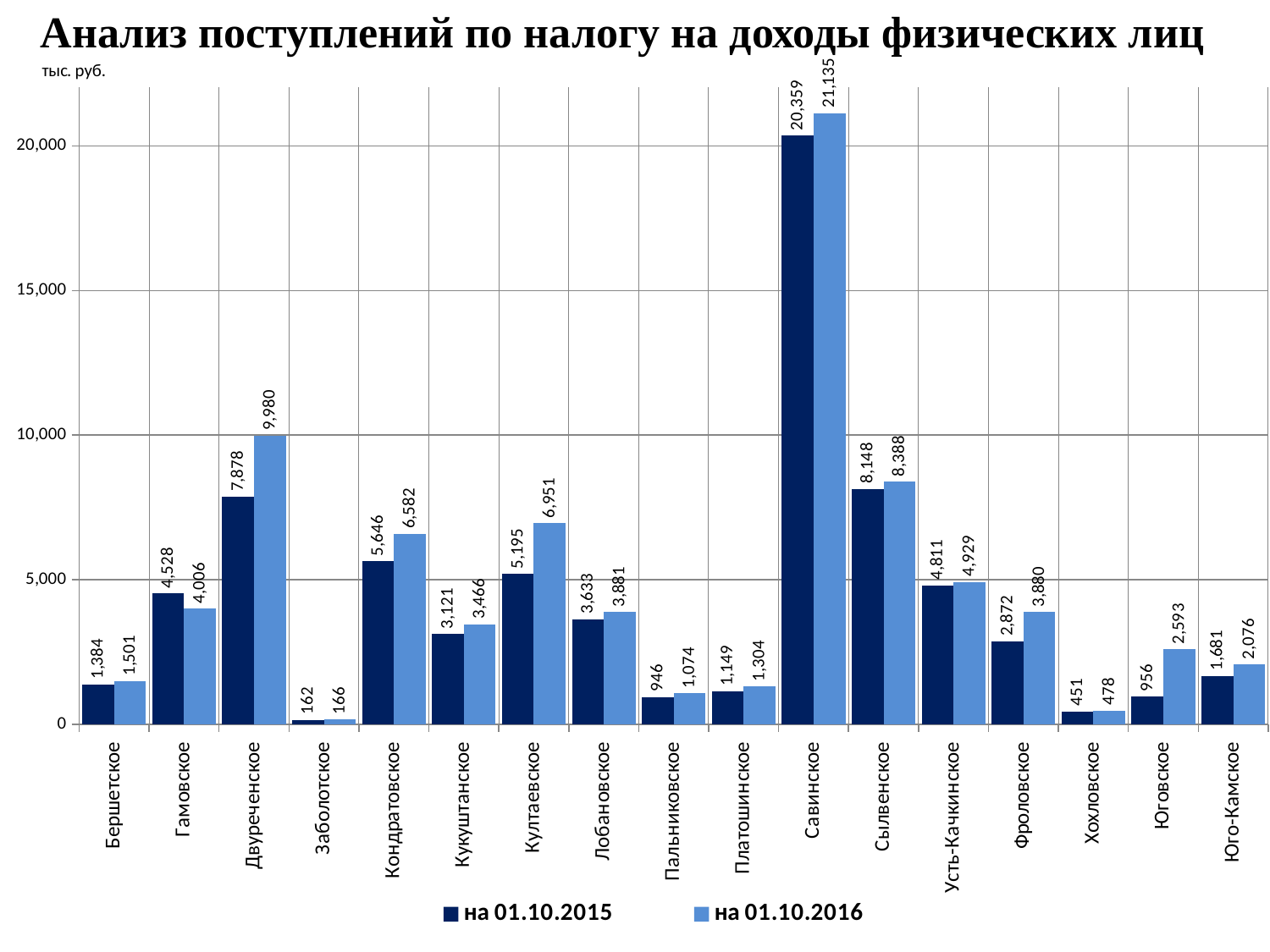
What kind of chart is shown on the slide? bar chart What is the difference between the на 01.10.2016 and на 01.10.2015 values for Савинское? 776 For Гамовское, which series has the larger value: на 01.10.2015 or на 01.10.2016? на 01.10.2015 What is the difference between the на 01.10.2016 and на 01.10.2015 values for Двуреченское? 2,102 Which category has the highest value in the series на 01.10.2015? Савинское What is the value for Савинское in the series на 01.10.2016? 21,135 What is the value for Двуреченское in the series на 01.10.2015? 7,878 How many series does the legend list? 2 How many categories are shown on the x axis? 17 What is the value for Юговское in the series на 01.10.2016? 2,593 Is the value for Сылвенское in the series на 01.10.2016 greater or less than 10,000? less Which category has the lowest value in the series на 01.10.2016? Заболотское